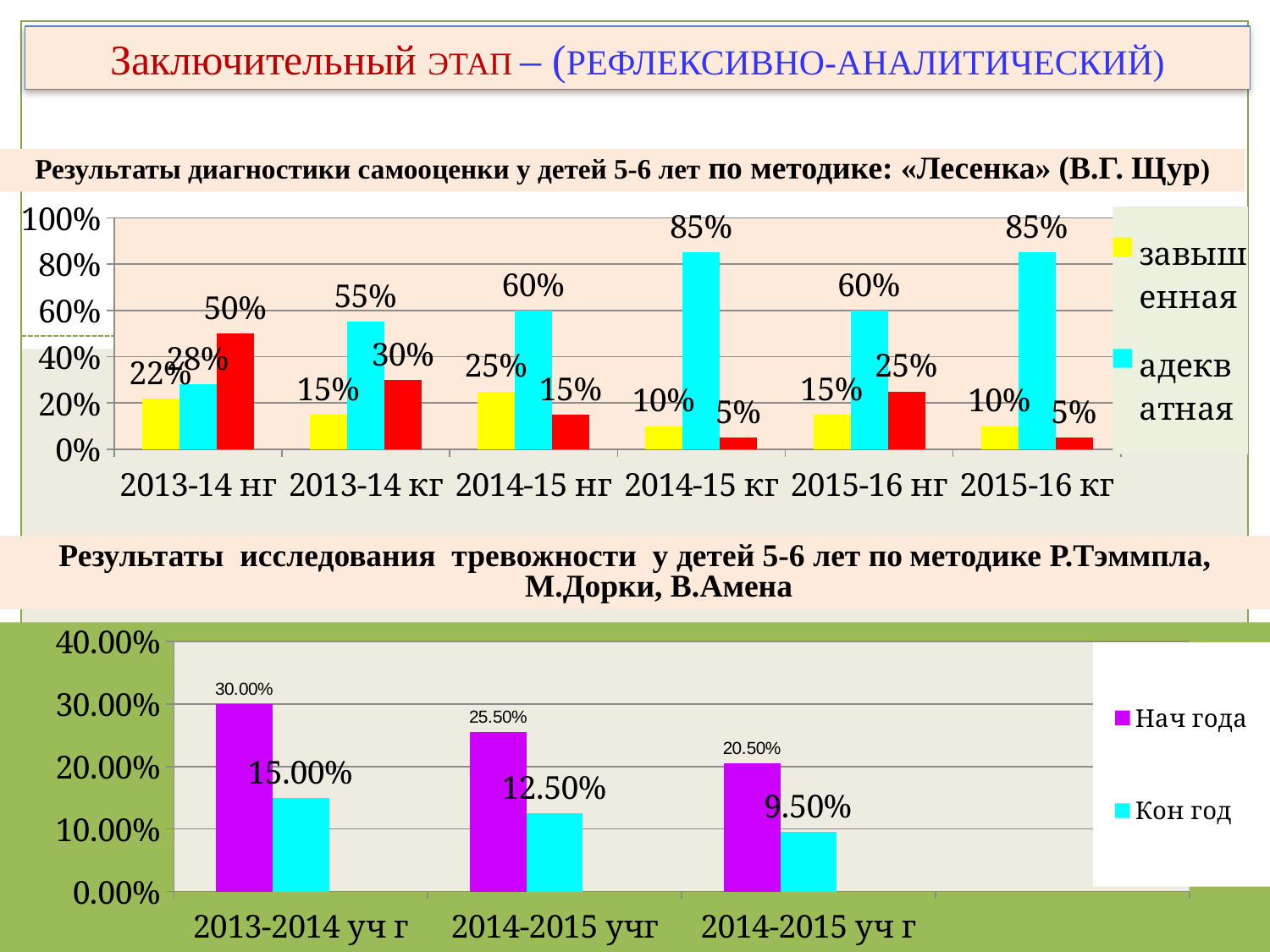
In the bottom chart (anxiety study), how many series does the legend list? 2 In the bottom chart (anxiety study), what is the lowest Кон год value? 9.50% In the bottom chart (anxiety study), do the Нач года values rise or fall from left to right along the x axis? Fall In the top chart (self-esteem diagnostics, «Лесенка»), which category has the highest адекватная value? 2014-15 кг and 2015-16 кг (85%) In the top chart (self-esteem diagnostics, «Лесенка»), what is the value of the завышенная series for 2014-15 нг? 25% In the bottom chart (anxiety study), what is the value of Нач года for 2013-2014 уч г? 30.00% In the top chart (self-esteem diagnostics, «Лесенка»), what is the value of the адекватная series for 2013-14 кг? 55% What type of chart is the top chart (self-esteem diagnostics, «Лесенка»)? Bar chart In the bottom chart (anxiety study), what is the difference between Нач года and Кон год for 2013-2014 уч г? 15.00% In the top chart (self-esteem diagnostics, «Лесенка»), what is the difference between the адекватная values for 2014-15 кг and 2014-15 нг? 25% In the top chart (self-esteem diagnostics, «Лесенка»), how many categories are shown on the x axis? 6 In the top chart (self-esteem diagnostics, «Лесенка»), which is larger: the завышенная value for 2013-14 нг or for 2013-14 кг? 2013-14 нг